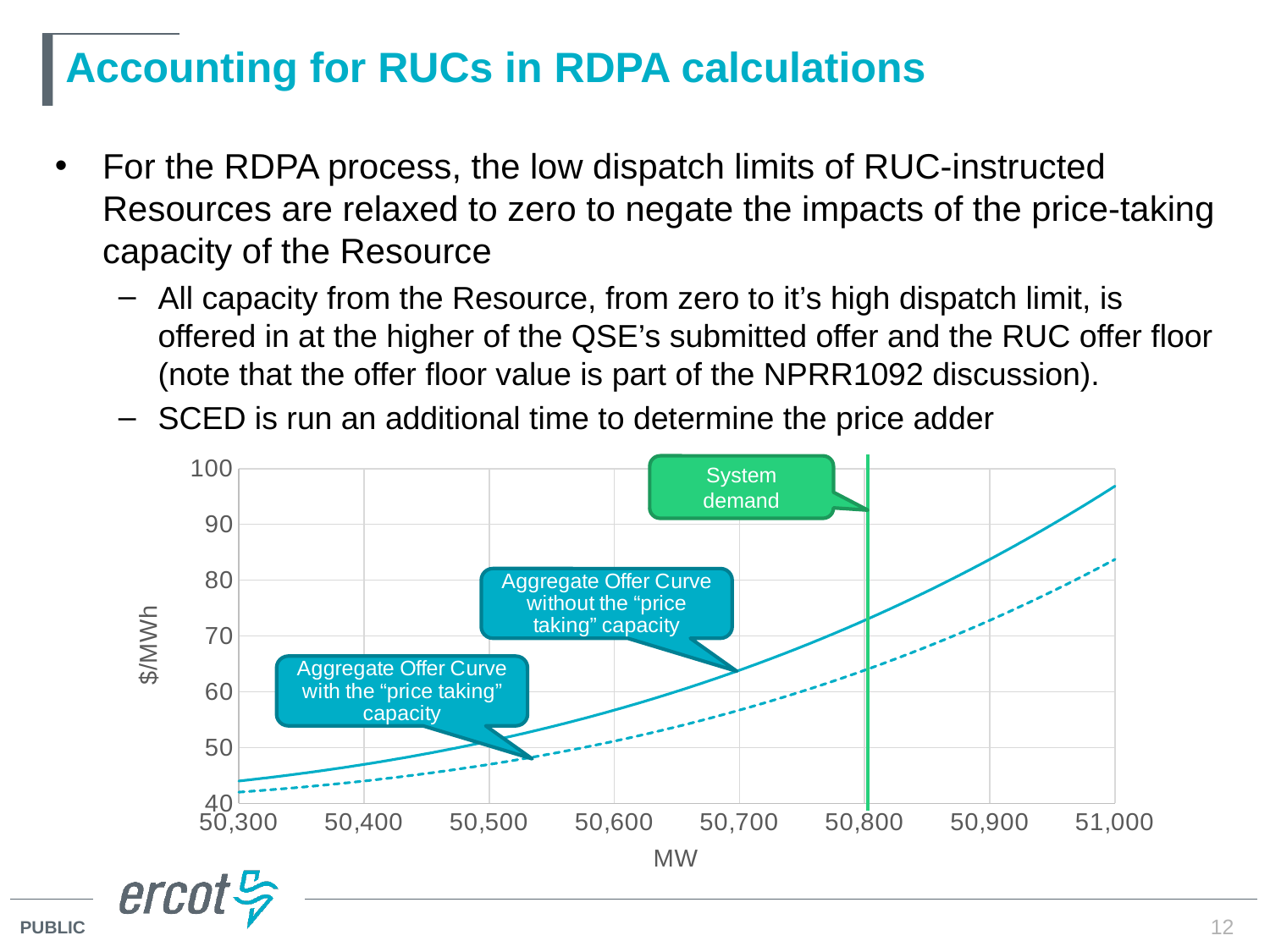
Do the offer curves rise or fall as MW increases along the x axis? rise At the system demand of 50,800 MW, which curve has the higher price: the curve with the 'price taking' capacity or the curve without it? the curve without the "price taking" capacity How many offer curves are plotted on the chart? 2 Is the value of the Aggregate Offer Curve without the 'price taking' capacity at 50,800 MW greater or less than 70 $/MWh? greater What is the label of the y axis of the chart? $/MWh At what MW value is the vertical 'System demand' line drawn? 50,800 Is the value of the Aggregate Offer Curve with the 'price taking' capacity at 50,800 MW greater or less than 70 $/MWh? less Is the value of the Aggregate Offer Curve with the 'price taking' capacity at 50,300 MW greater or less than 50 $/MWh? less Which curve is drawn as a dashed line: the Aggregate Offer Curve with the 'price taking' capacity or the one without it? the curve with the "price taking" capacity What kind of chart is shown on the slide? line chart What is the label of the x axis of the chart? MW